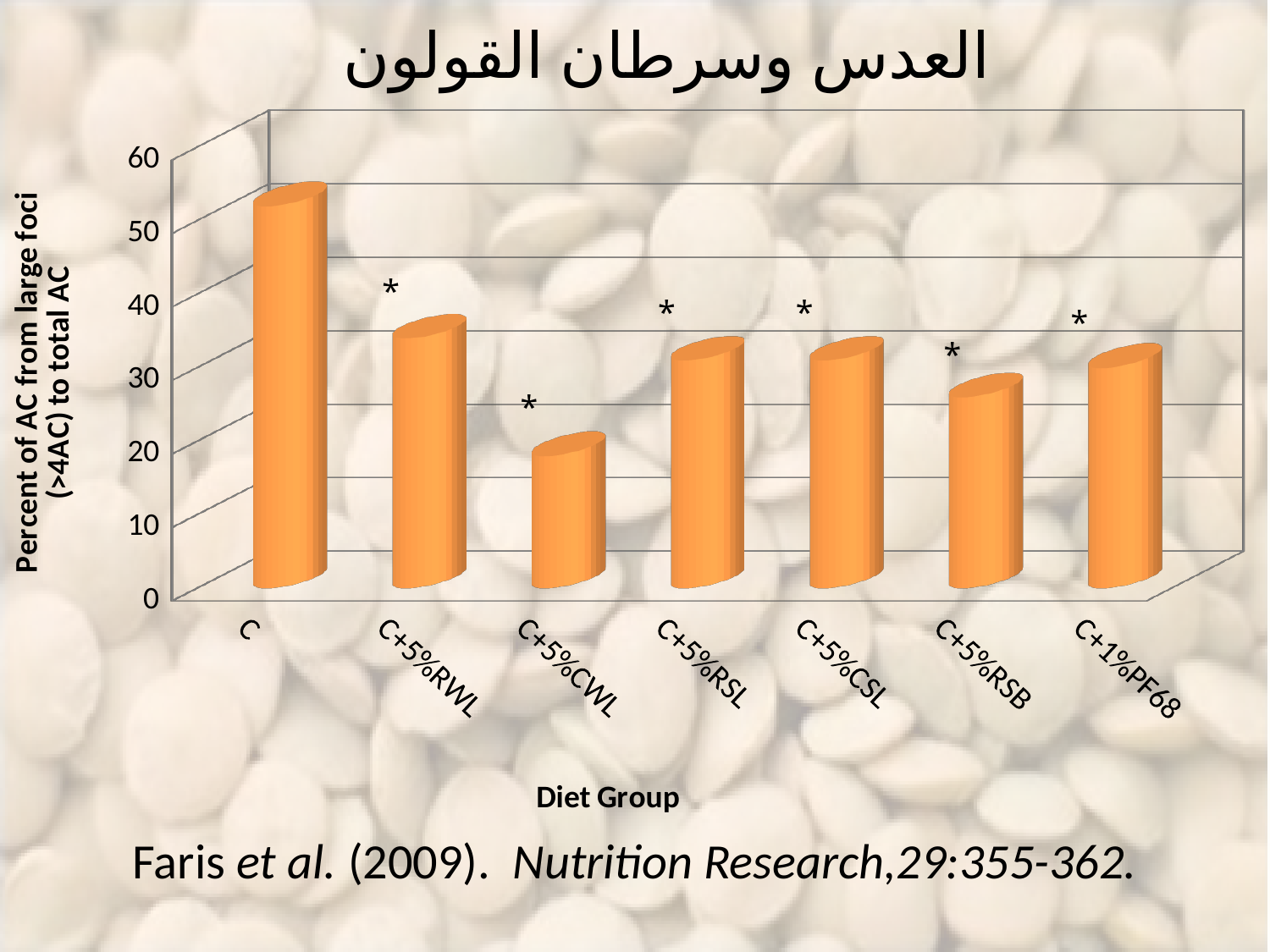
Is the value for C+5%CWL greater or less than 30? less Is the value for C+1%PF68 greater or less than 20? greater Which is larger, the value for C or the value for C+5%CWL? C Which diet group has the lowest percent of AC from large foci? C+5%CWL What is the title of the x axis of the chart? Diet Group Which diet group has the highest percent of AC from large foci? C How many diet groups are shown on the x axis of the chart? 7 Is the value for C greater or less than 40? greater What kind of chart is shown on the slide? bar chart Which is larger, the value for C+5%RWL or the value for C+5%RSB? C+5%RWL